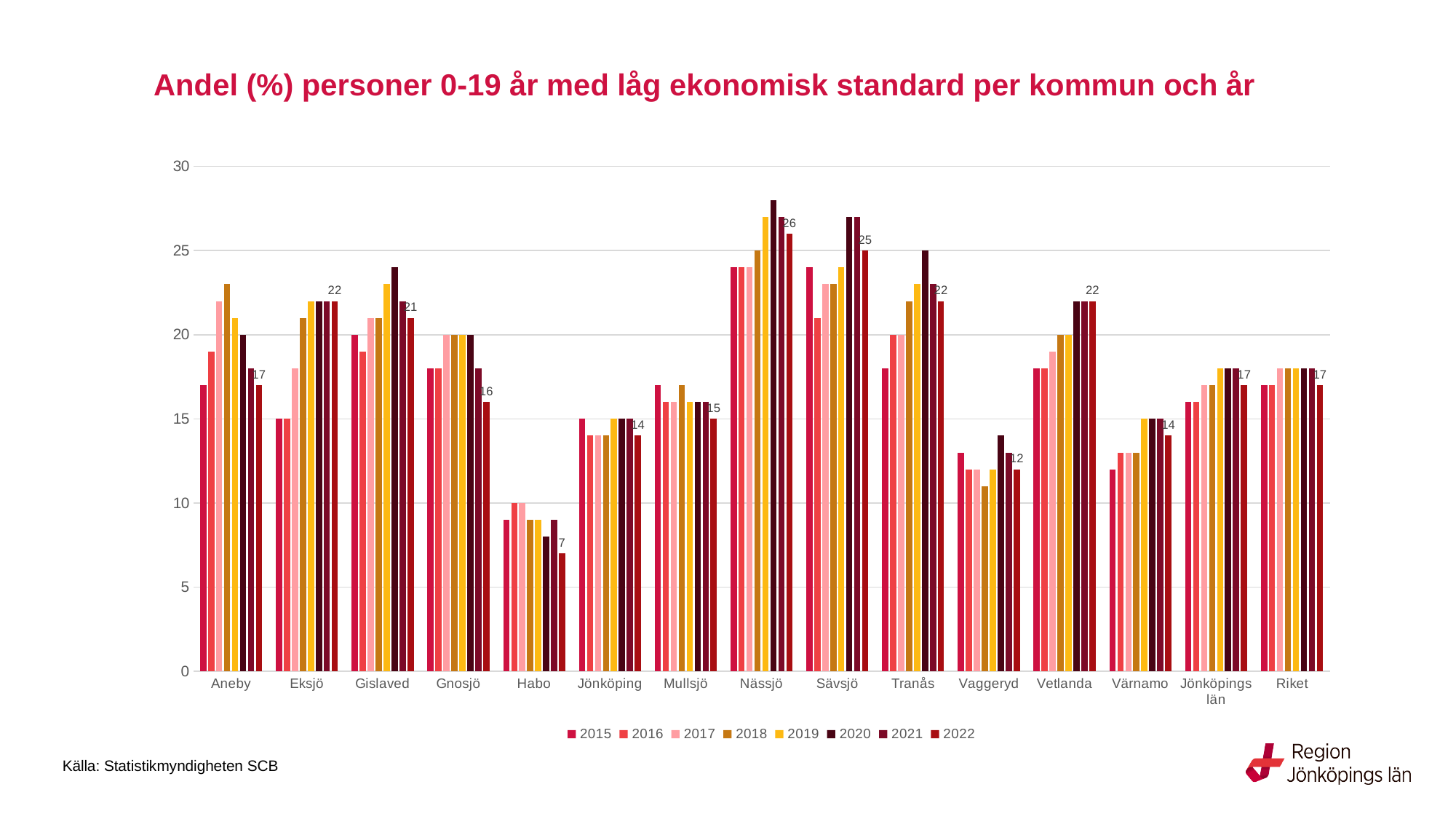
What is the value for Habo in 2022? 7 What kind of chart is shown on the slide? Bar chart What is the difference between the 2022 values for Nässjö and Habo? 19 Which category has the highest value in 2022? Nässjö What is the value for Riket in 2022? 17 Which category has the lowest value in 2022? Habo Is the value for Habo in 2015 greater or less than 10? less How many series does the legend list? 8 Which is larger in 2022, Sävsjö or Vaggeryd? Sävsjö Is the value for Nässjö in 2020 greater or less than 25? greater What is the value for Nässjö in 2022? 26 How many categories are shown on the x axis? 15